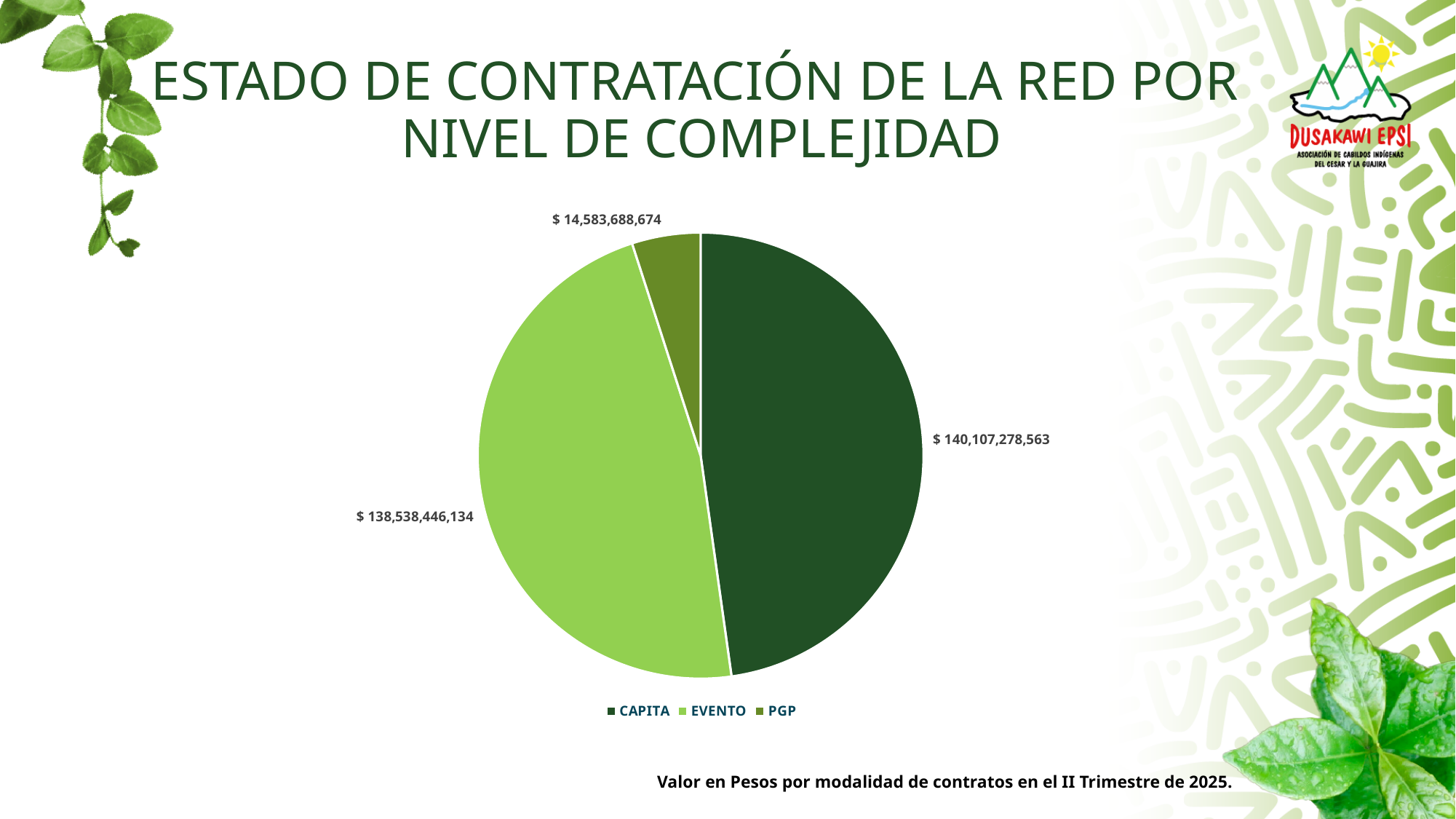
What is the difference between the values for CAPITA and EVENTO? $ 1,568,832,429 How many entries does the legend list? 3 What is the difference between the values for EVENTO and PGP? $ 123,954,757,460 What is the value for PGP in the pie chart? $ 14,583,688,674 Which is larger, the value for CAPITA or the value for PGP? CAPITA What is the title of the slide containing the pie chart? ESTADO DE CONTRATACIÓN DE LA RED POR NIVEL DE COMPLEJIDAD What is the value for EVENTO in the pie chart? $ 138,538,446,134 What is the value for CAPITA in the pie chart? $ 140,107,278,563 What type of chart is shown on the slide? Pie chart How many categories does the pie chart show? 3 Which is larger, the value for EVENTO or the value for PGP? EVENTO Which category has the smallest slice in the pie chart? PGP